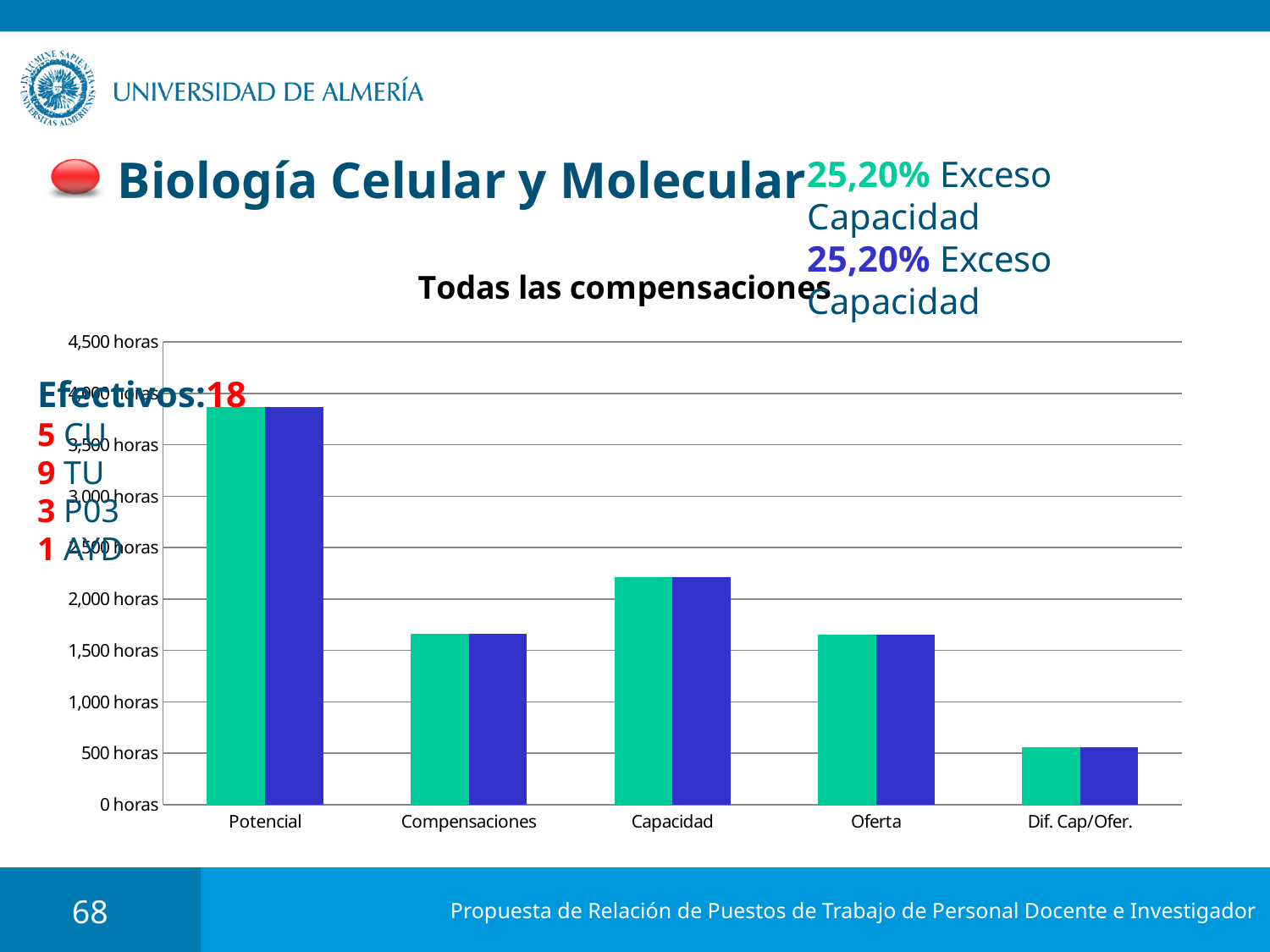
Which is larger, the value for Capacidad or the value for Oferta? Capacidad Which category has the highest value in the chart? Potencial How many categories are shown on the x axis of the chart? 5 What is the title of the chart? Todas las compensaciones Is the value for Capacidad greater or less than 2,000 horas? greater Is the value for Dif. Cap/Ofer. greater or less than 1,000 horas? less Is the value for Oferta greater or less than 2,000 horas? less Which is larger, the value for Potencial or the value for Capacidad? Potencial What is the highest value shown on the y axis of the chart? 4,500 horas What kind of chart is shown on the slide? bar chart Which category has the lowest value in the chart? Dif. Cap/Ofer.